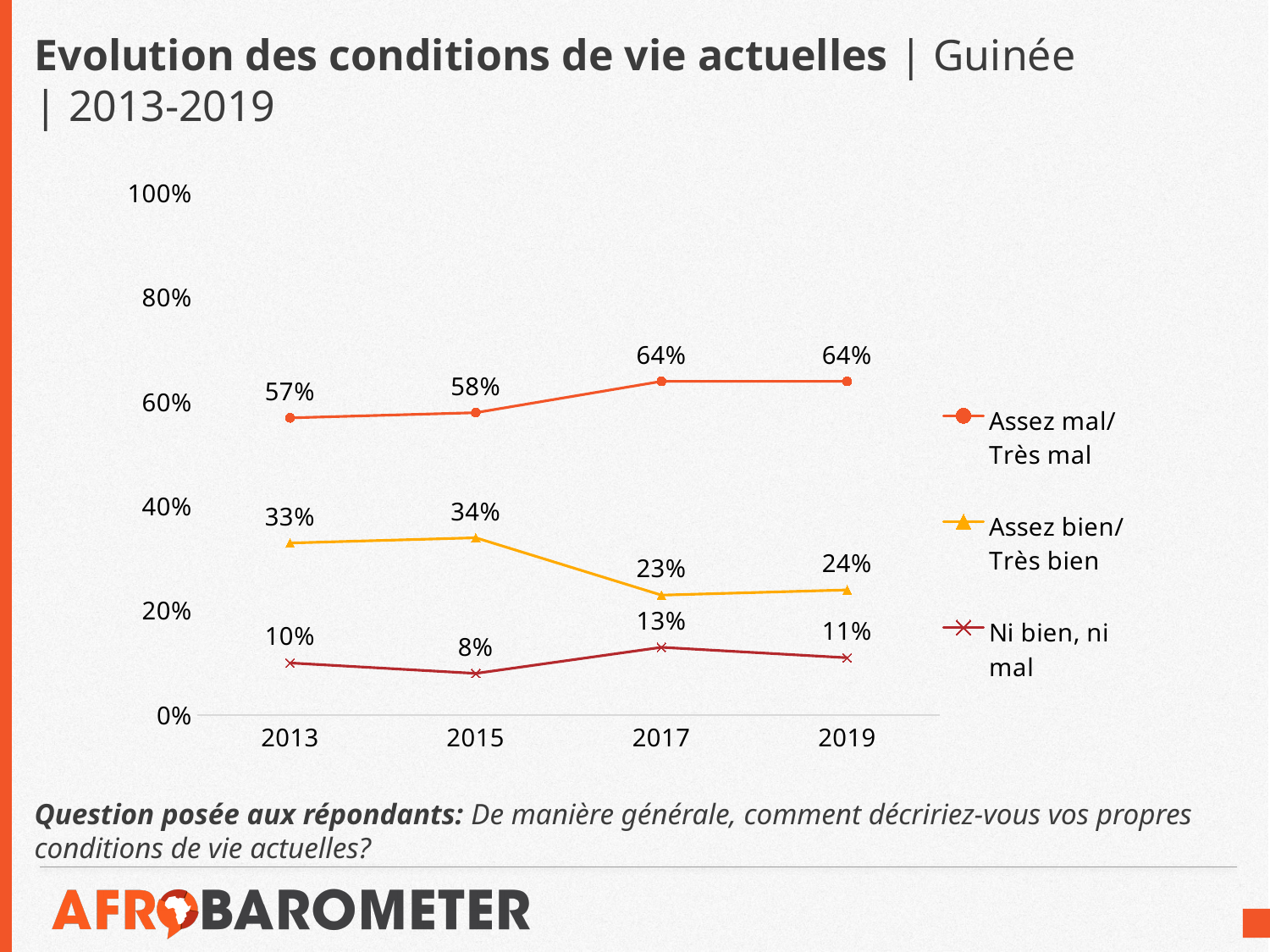
What kind of chart is shown on the slide? Line chart What is the difference between the Assez mal/Très mal value in 2019 and in 2013? 7 percentage points What is the value for Assez bien/Très bien in 2017? 23% In which year is the Assez bien/Très bien series highest? 2015 In which year is the Ni bien, ni mal series lowest? 2015 Does the Assez bien/Très bien series rise or fall from 2015 to 2017? Fall How many years are shown on the x axis? 4 How many series does the legend list? 3 What is the value for Assez mal/Très mal in 2013? 57% What is the value for Ni bien, ni mal in 2015? 8% Which is larger in 2019: Assez bien/Très bien or Ni bien, ni mal? Assez bien/Très bien Is the value for Assez mal/Très mal in 2017 greater or less than 60%? greater